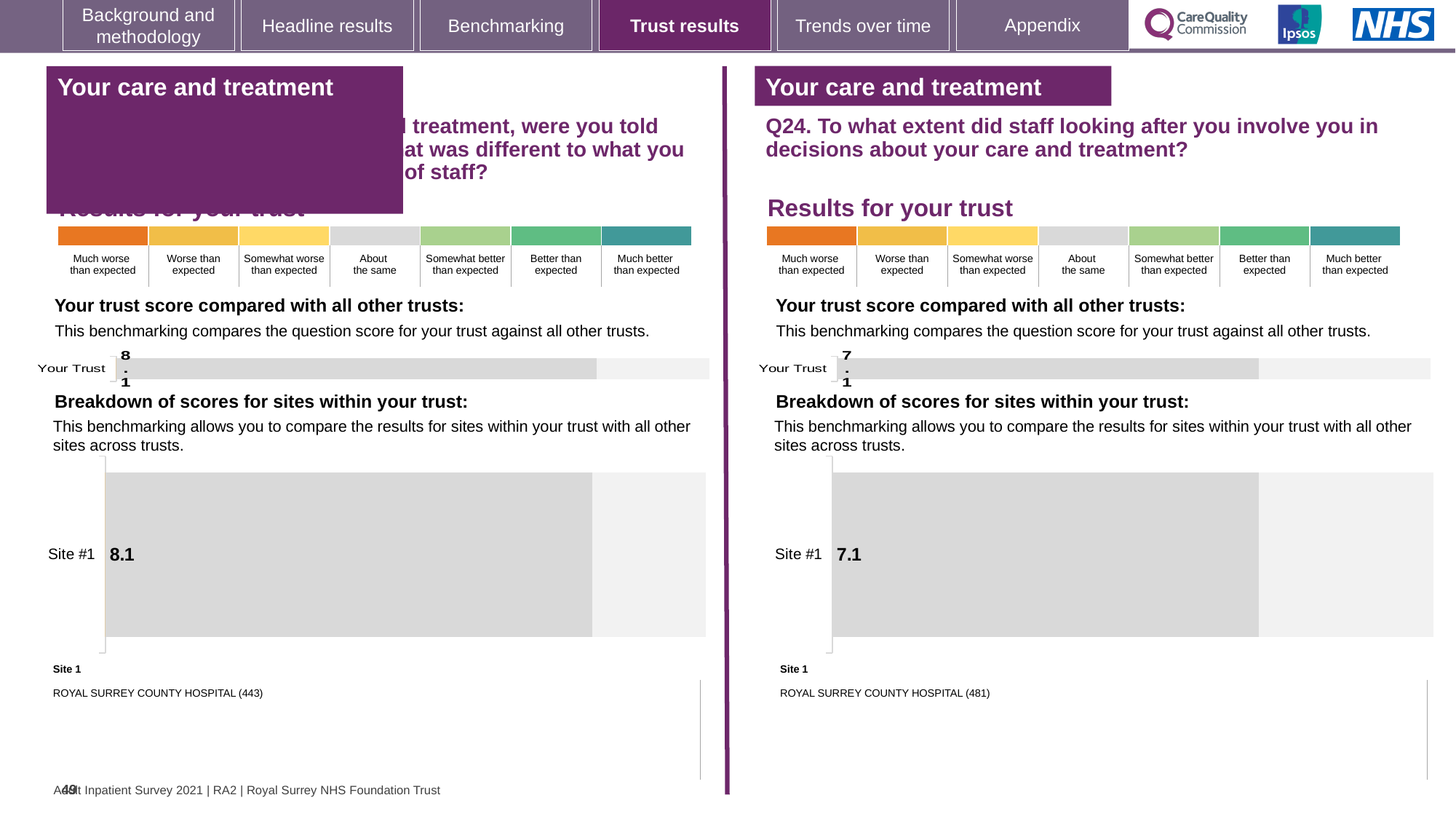
How many sites are shown in the 'Breakdown of scores for sites within your trust' chart on the right panel (Q24)? 1 On the left panel, what is the score shown for Your Trust in the 'Your trust score compared with all other trusts' chart? 8.1 On the right panel (Q24), is the Site #1 score the same as the Your Trust score? Yes What type of chart is used to show the Site #1 score on the left panel? Bar chart On the right panel (Q24), what is the score for Site #1 in the 'Breakdown of scores for sites within your trust' chart? 7.1 On the right panel (Q24), what is the score shown for Your Trust in the 'Your trust score compared with all other trusts' chart? 7.1 Which site is listed as Site 1 on the left panel? ROYAL SURREY COUNTY HOSPITAL (443) On the left panel, what is the score for Site #1 in the 'Breakdown of scores for sites within your trust' chart? 8.1 What is the difference between the Your Trust score on the left panel (8.1) and the Your Trust score on the right panel (7.1)? 1.0 Which site is listed as Site 1 on the right panel (Q24)? ROYAL SURREY COUNTY HOSPITAL (481) Which is larger: the Your Trust score on the left panel or the Your Trust score on the right panel (Q24)? Left panel